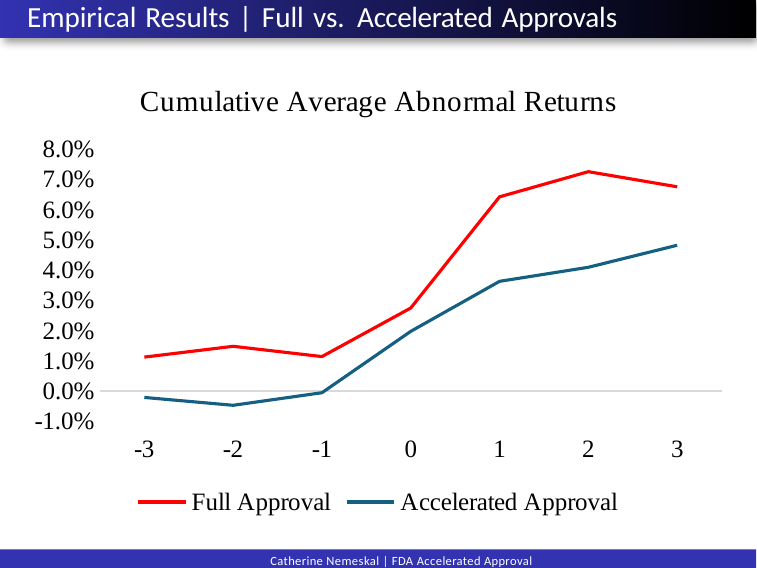
How many points along the x axis are plotted for each series? 7 How many series does the legend list? 2 Is the value for Accelerated Approval at x = 1 greater or less than 3.0%? greater At x = 3, which series has the higher value, Full Approval or Accelerated Approval? Full Approval At which x value does the Full Approval series reach its highest point? 2 What kind of chart is shown on the slide? line chart Does the Accelerated Approval series generally rise or fall from x = -1 to x = 3? rise What is the title of the chart? Cumulative Average Abnormal Returns Which series is drawn in red? Full Approval At which x value does the Accelerated Approval series reach its lowest point? -2 Is the value for Full Approval at x = 1 greater or less than 6.0%? greater Is the value for Accelerated Approval at x = -2 greater or less than 0.0%? less